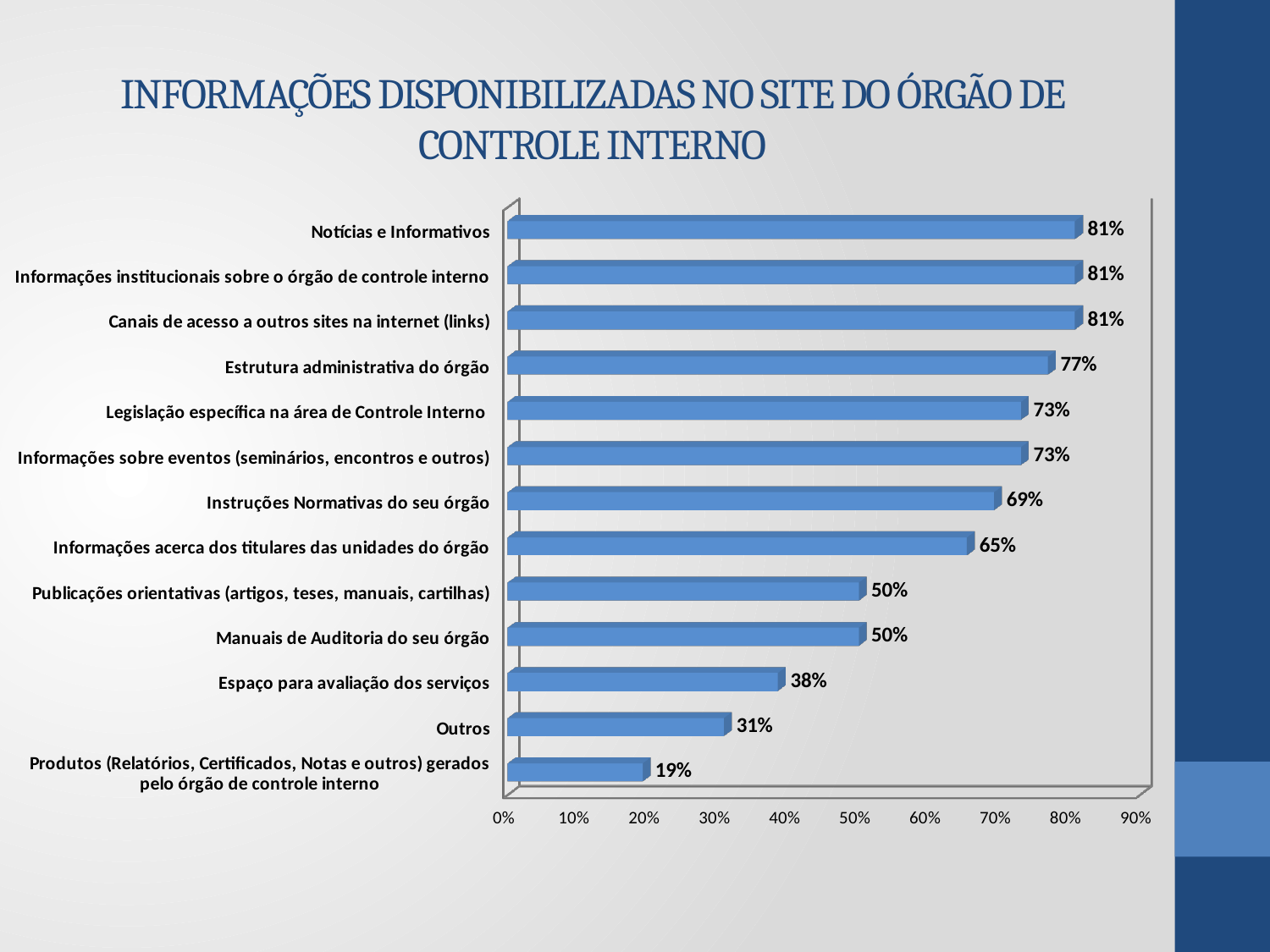
What is the value for "Outros"? 31% What is the title of the slide? INFORMAÇÕES DISPONIBILIZADAS NO SITE DO ÓRGÃO DE CONTROLE INTERNO What is the value for "Estrutura administrativa do órgão"? 77% What is the difference between the values for "Informações acerca dos titulares das unidades do órgão" and "Outros"? 34% What is the difference between the values for "Notícias e Informativos" and "Manuais de Auditoria do seu órgão"? 31% What is the value for "Espaço para avaliação dos serviços"? 38% Is the value for "Espaço para avaliação dos serviços" greater or less than 40%? less Which category has the lowest value? Produtos (Relatórios, Certificados, Notas e outros) gerados pelo órgão de controle interno What kind of chart is shown on the slide? Bar chart What is the value for "Instruções Normativas do seu órgão"? 69% How many categories are shown in the chart? 13 Which is larger, the value for "Legislação específica na área de Controle Interno" or the value for "Publicações orientativas (artigos, teses, manuais, cartilhas)"? Legislação específica na área de Controle Interno